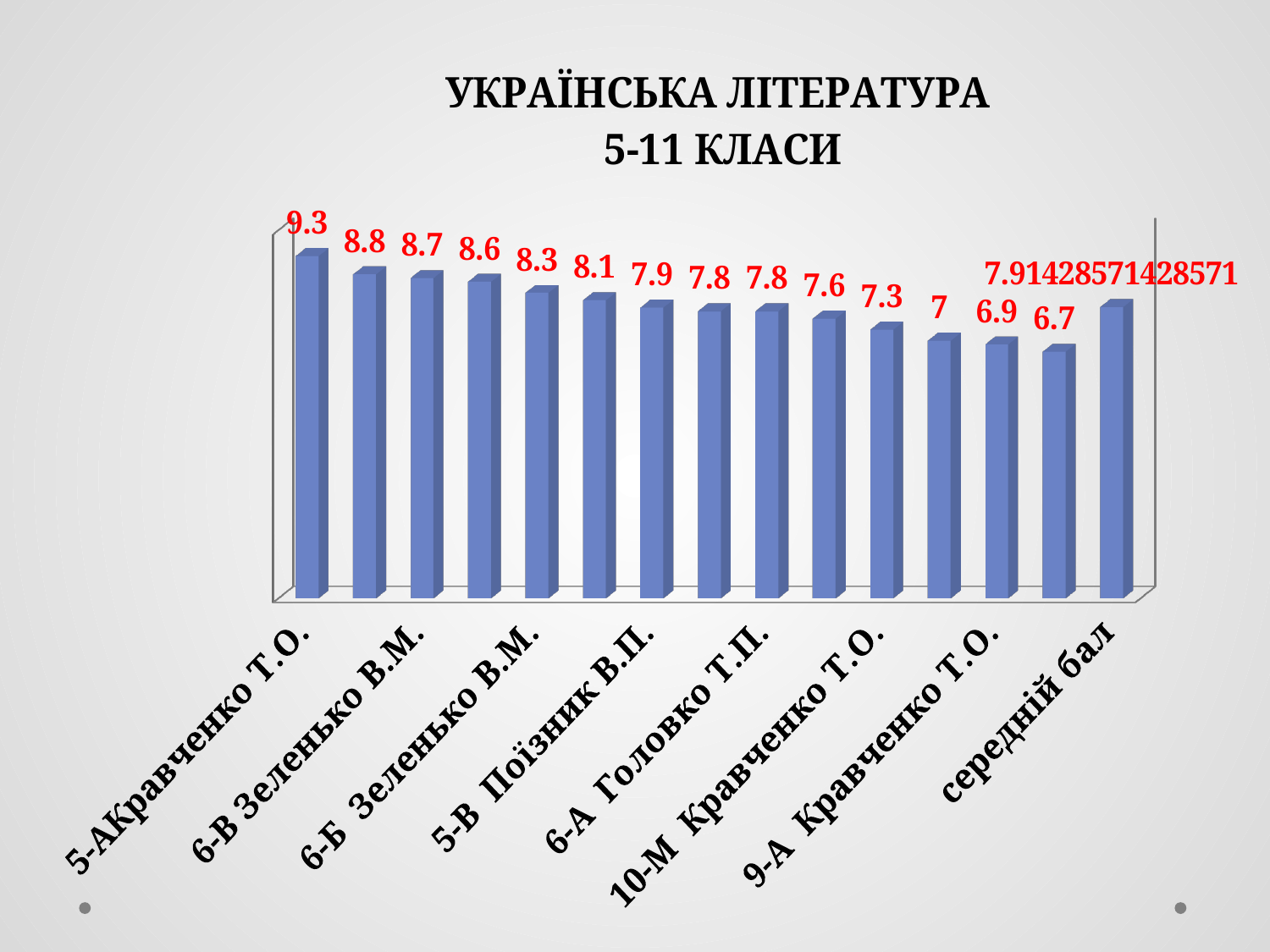
What is the value shown for середній бал? 7.91428571428571 What is the difference between the values for 5-А Кравченко Т.О. and 9-А Кравченко Т.О.? 2.4 What is the value for 5-А Кравченко Т.О.? 9.3 What is the lowest value shown on the chart? 6.7 How many bars are plotted on the chart? 15 What is the value for 6-Б Зеленько В.М.? 8.3 What is the value for 5-В Поїзник В.П.? 7.9 What kind of chart is shown on the slide? bar chart Which category has the highest value? 5-А Кравченко Т.О. What is the value for 10-М Кравченко Т.О.? 7.3 What is the value for 6-В Зеленько В.М.? 8.7 What is the value for 9-А Кравченко Т.О.? 6.9